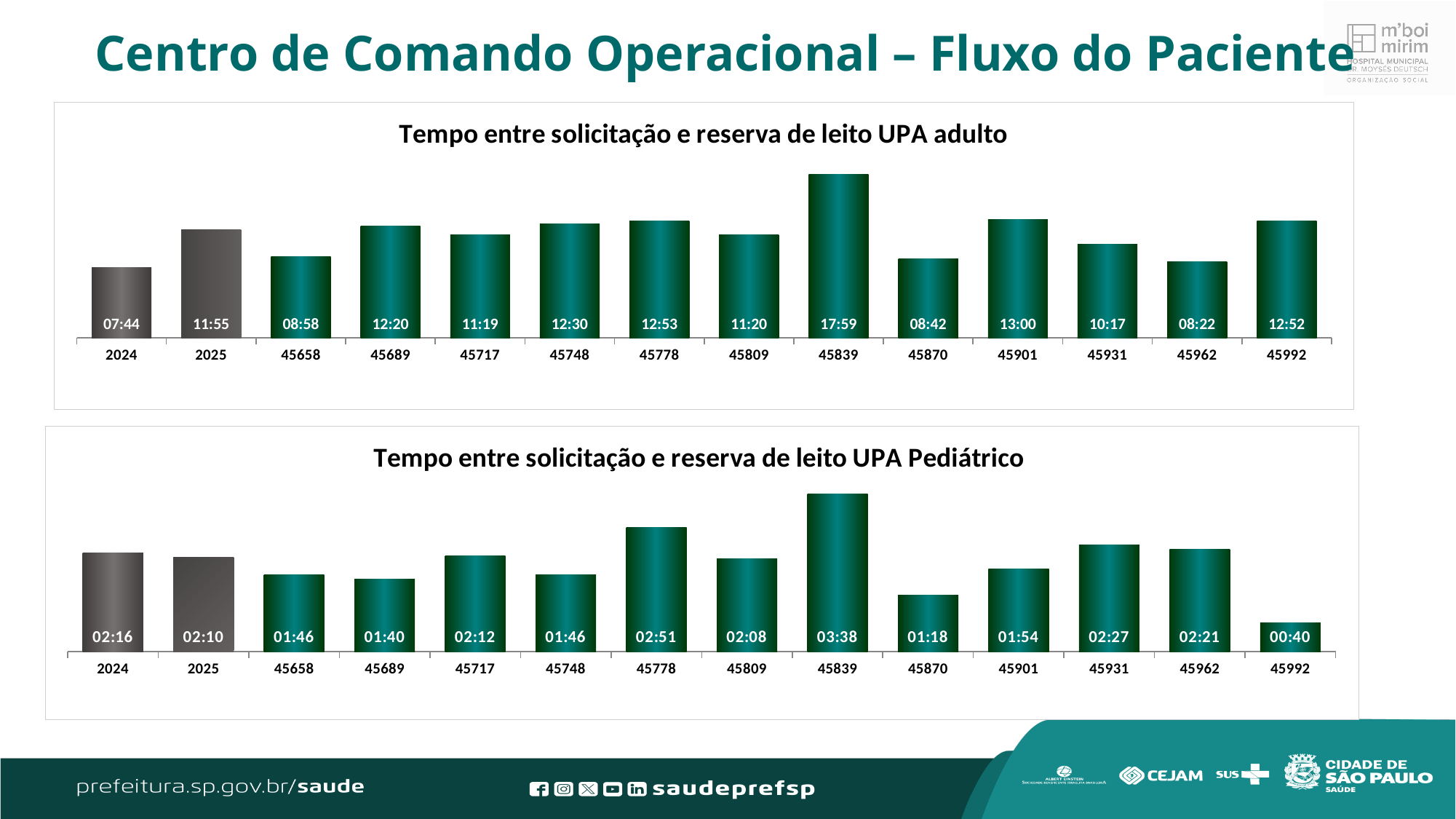
In the top chart (UPA adulto), what is the value for 2024? 07:44 In the bottom chart (UPA Pediátrico), which category has the highest value? 45839 In the top chart (UPA adulto), which category has the highest value? 45839 In the bottom chart (UPA Pediátrico), which is larger, the value for 45778 or the value for 45809? 45778 In the bottom chart (UPA Pediátrico), which category has the lowest value? 45992 In the top chart (UPA adulto), what is the difference between the values for 2025 and 2024? 04:11 In the top chart (UPA adulto), which category has the lowest value? 2024 In the bottom chart (UPA Pediátrico), what is the difference between the values for 45839 and 45870? 02:20 What kind of chart is the bottom chart (UPA Pediátrico)? Bar chart In the bottom chart (UPA Pediátrico), what is the value for 45992? 00:40 In the top chart (UPA adulto), how many bars are plotted? 14 In the top chart (UPA adulto), what is the value for 45839? 17:59